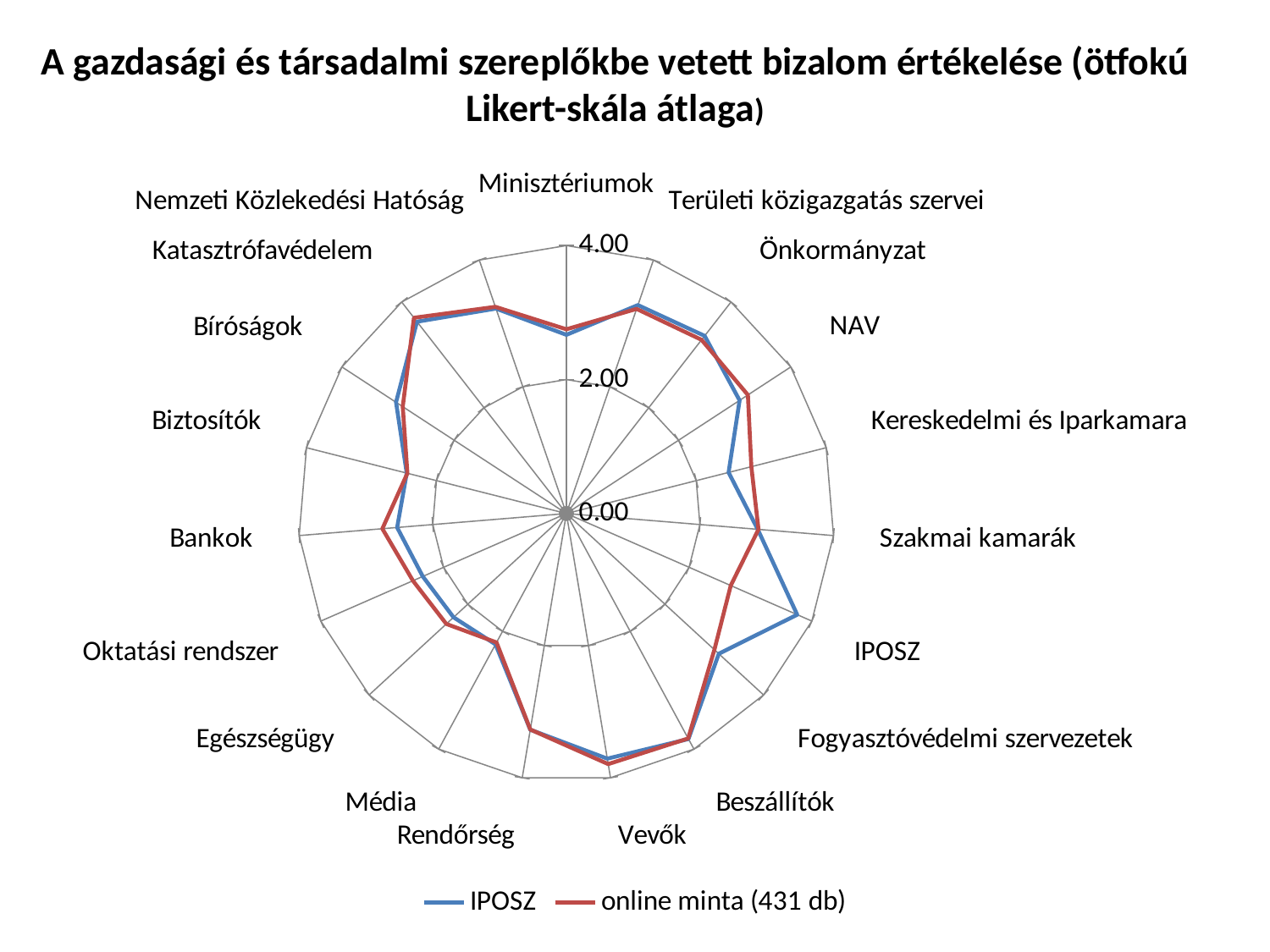
Is the online minta (431 db) value for Vevők greater or less than 2.00? greater How many series does the legend list? 2 What kind of chart is shown on the slide? Radar chart Is the IPOSZ value for the IPOSZ category greater or less than 4.00? less Which two series are listed in the legend? IPOSZ and online minta (431 db) Is the IPOSZ value for Beszállítók greater or less than 2.00? greater How many categories (axes) does the radar chart have? 19 For Kereskedelmi és Iparkamara, which series has the larger value, IPOSZ or online minta (431 db)? online minta (431 db) For the IPOSZ category, which series has the larger value, IPOSZ or online minta (431 db)? IPOSZ What is the highest value shown on the radial axis of the chart? 4.00